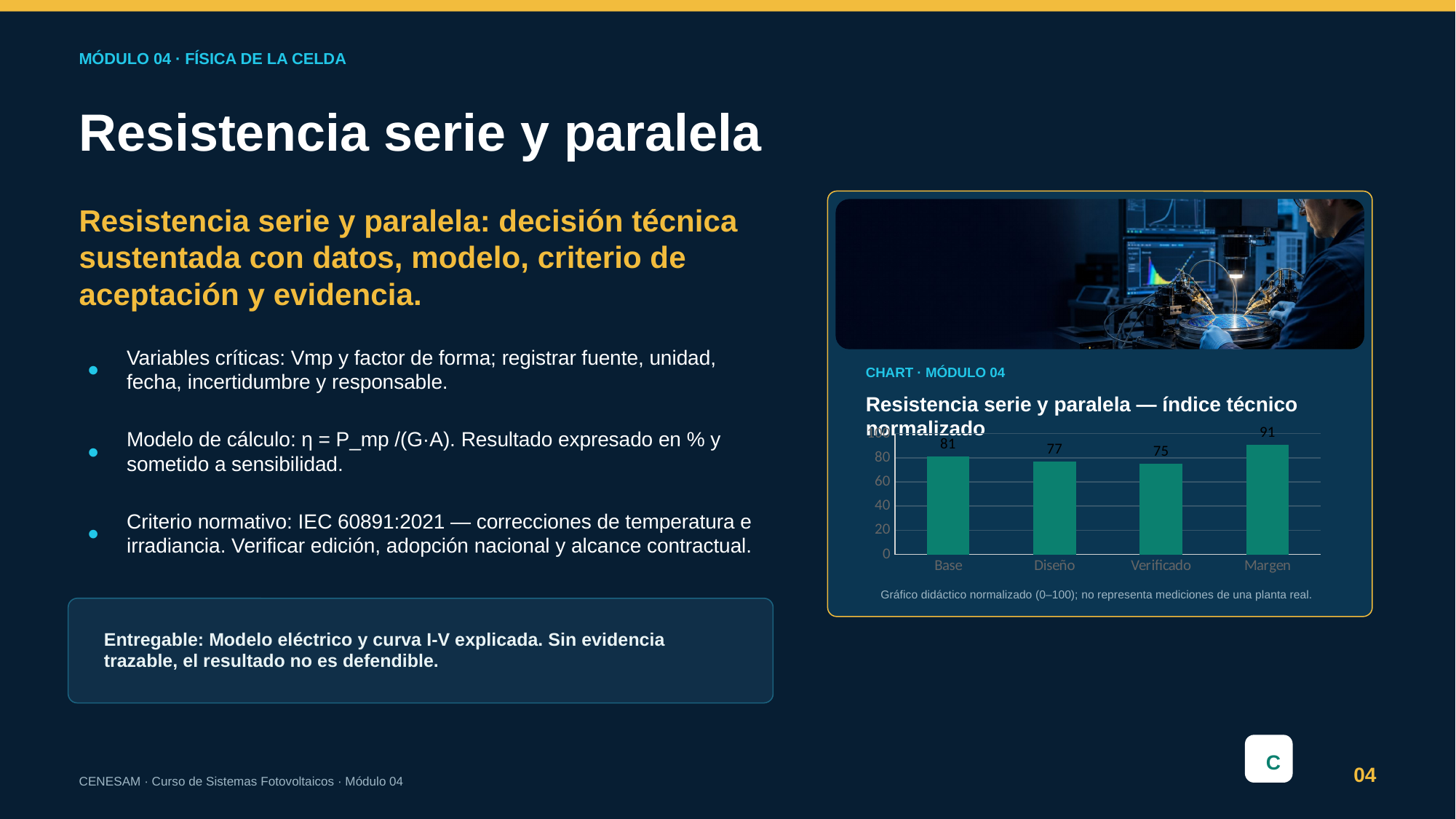
How many categories are shown on the x axis? 4 What kind of chart is shown? Bar chart What is the value for Diseño? 77 What is the difference between the values for Margen and Verificado? 16 Which category has the highest value? Margen Which category has the lowest value? Verificado Which is larger, the value for Base or the value for Diseño? Base What is the value for Margen? 91 What is the value for Base? 81 Is the value for Margen greater or less than 80? greater What is the title of the chart? Resistencia serie y paralela — índice técnico normalizado What is the value for Verificado? 75